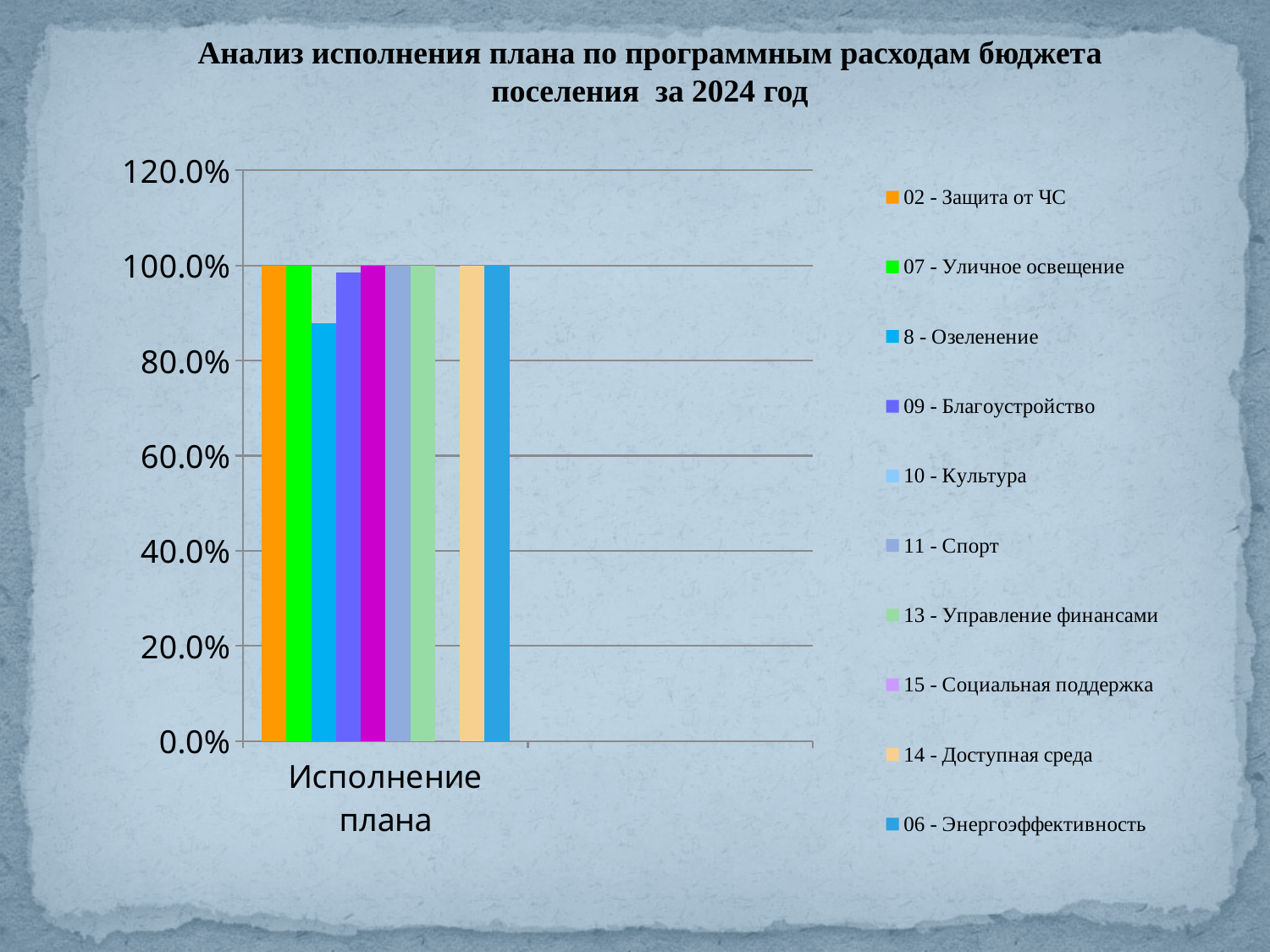
What is the category label on the x axis? Исполнение плана Is the value for 8 - Озеленение greater or less than 100.0%? less How many series does the legend list? 10 Is the value for 8 - Озеленение greater or less than 80.0%? greater What is the value for 07 - Уличное освещение? 100.0% What is the title of the chart? Анализ исполнения плана по программным расходам бюджета поселения за 2024 год How many categories are shown on the x axis? 1 What kind of chart is shown on the slide? bar chart What is the value for 06 - Энергоэффективность? 100.0% Which is larger, the value for 02 - Защита от ЧС or the value for 8 - Озеленение? 02 - Защита от ЧС What is the value for 02 - Защита от ЧС? 100.0%